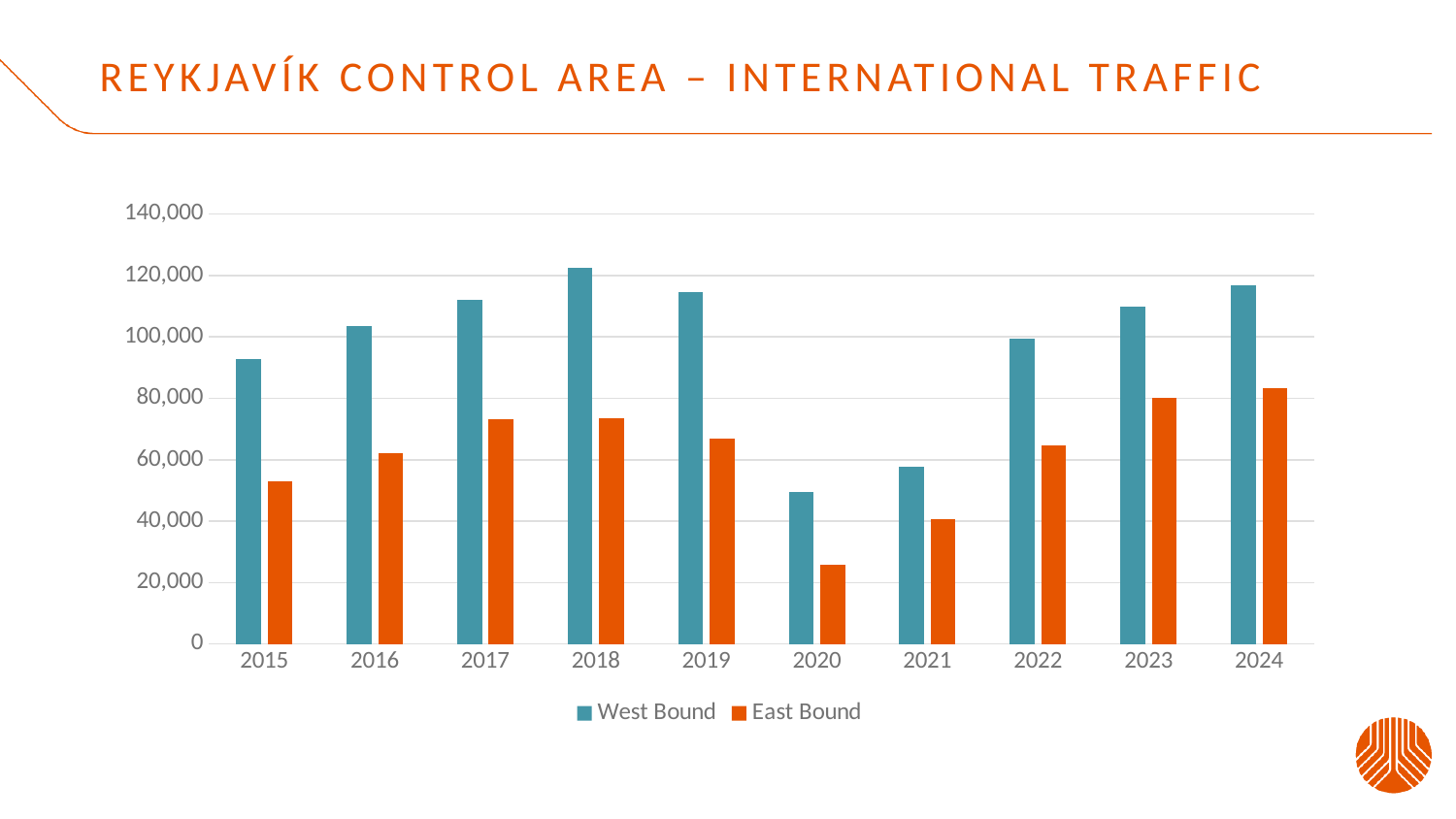
In which year is the East Bound value lowest? 2020 Do the West Bound values rise or fall from 2020 to 2024? rise Is the East Bound value for 2020 greater or less than 40,000? less In which year is the West Bound value highest? 2018 Which is larger in 2015, the West Bound value or the East Bound value? West Bound What type of chart is shown on the slide? Bar chart How many years are shown on the x axis? 10 Which is larger for East Bound, the value for 2015 or the value for 2021? 2015 Is the West Bound value for 2024 greater or less than 100,000? greater In which year is the West Bound value lowest? 2020 How many series does the legend list? 2 Is the West Bound value for 2020 greater or less than 60,000? less